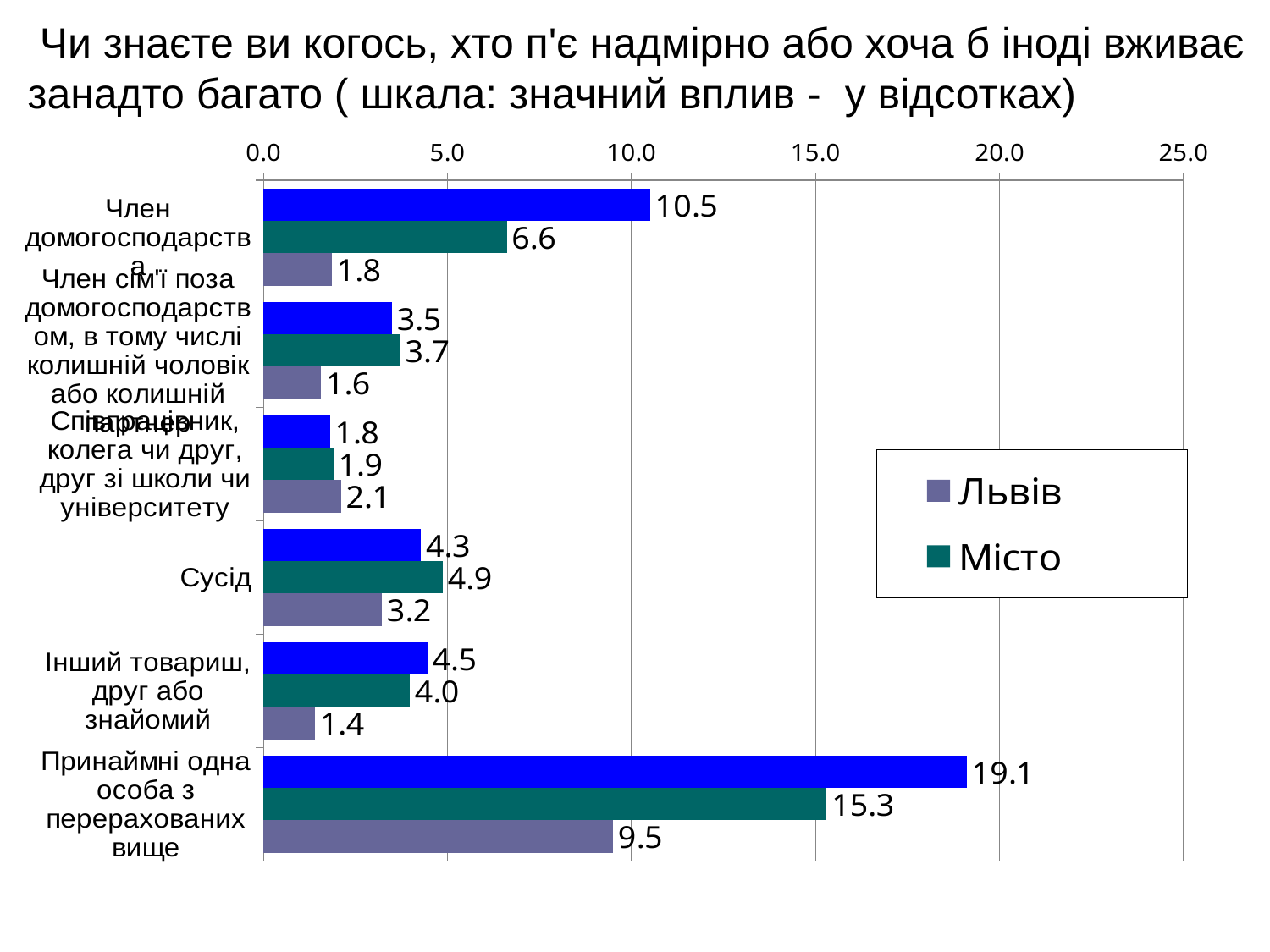
What is the difference between the Місто and Львів values for Принаймні одна особа з перерахованих вище? 5.8 What is the value for Львів in the category Сусід? 3.2 Which category has the lowest value for the Львів series? Інший товариш, друг або знайомий Which category has the highest value for the Львів series? Принаймні одна особа з перерахованих вище What is the value for Львів in the category Співпрацівник, колега чи друг, друг зі школи чи університету? 2.1 Which category has the highest value for the Місто series? Принаймні одна особа з перерахованих вище What is the difference between the Місто and Львів values for Сусід? 1.7 What is the value for Місто in the category Член домогосподарства? 6.6 For the category Член домогосподарства, which is larger: the Місто value or the Львів value? Місто How many categories are shown on the chart? 6 What is the value for Місто in the category Інший товариш, друг або знайомий? 4.0 How many series does the legend list? 2